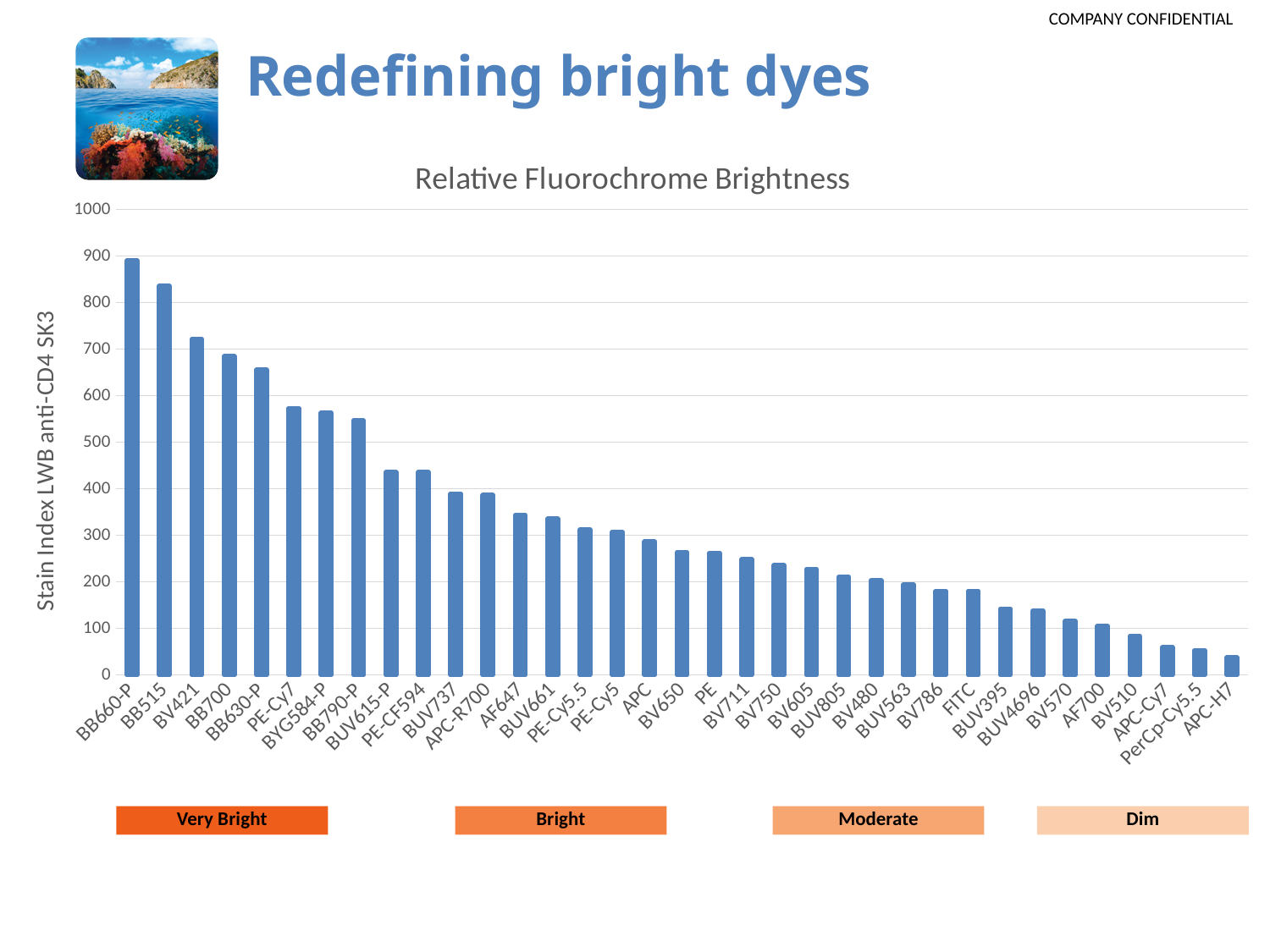
Do the stain index values rise or fall moving from left to right along the x axis? fall Is the value for FITC greater or less than 200? less What is the title of the chart? Relative Fluorochrome Brightness Is the value for PE-Cy7 greater or less than 500? greater Is the value for APC-H7 greater or less than 100? less What type of chart is shown on the slide? bar chart Which has a higher stain index, BV421 or BB700? BV421 How many fluorochromes are plotted in the chart? 35 Which fluorochrome has the highest stain index in the chart? BB660-P Which fluorochrome has the lowest stain index in the chart? APC-H7